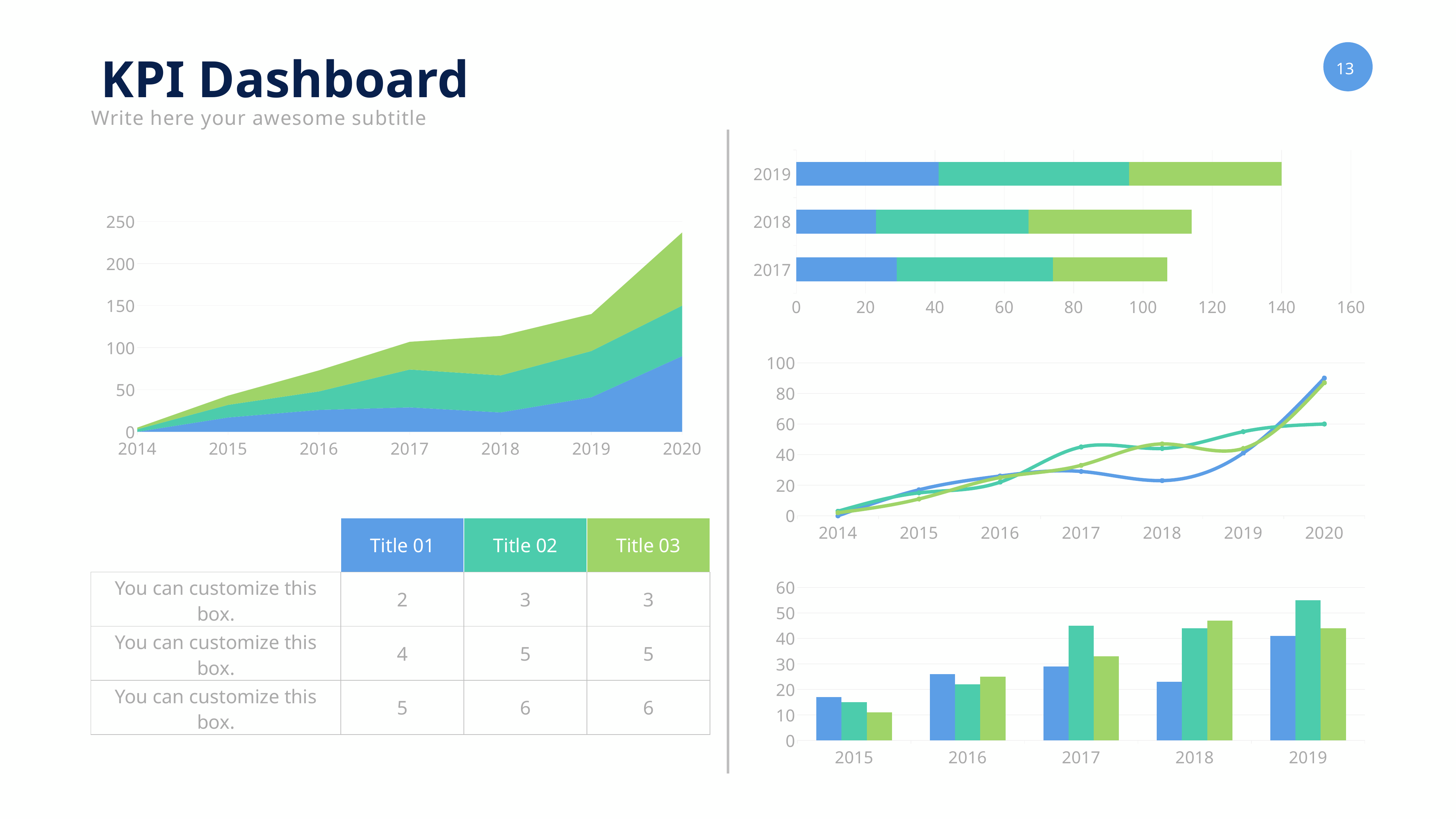
In the top-left area chart, is the total stacked value for 2020 greater or less than 200? greater In the top-right horizontal bar chart, is the total bar for 2019 greater or less than 120? greater What kind of chart is the top-left chart on the slide? area chart What kind of chart is the top-right chart on the slide? bar chart How many years are shown on the x axis of the top-left area chart? 7 How many categories (years) are shown in the top-right horizontal bar chart? 3 In the top-left area chart, do the stacked values generally rise or fall from 2014 to 2020? rise In the top-right horizontal bar chart, which year has the longest total bar? 2019 How many categories (years) are shown on the x axis of the bottom-right bar chart? 5 In the bottom-right bar chart, is the teal bar for 2019 greater or less than 50? greater